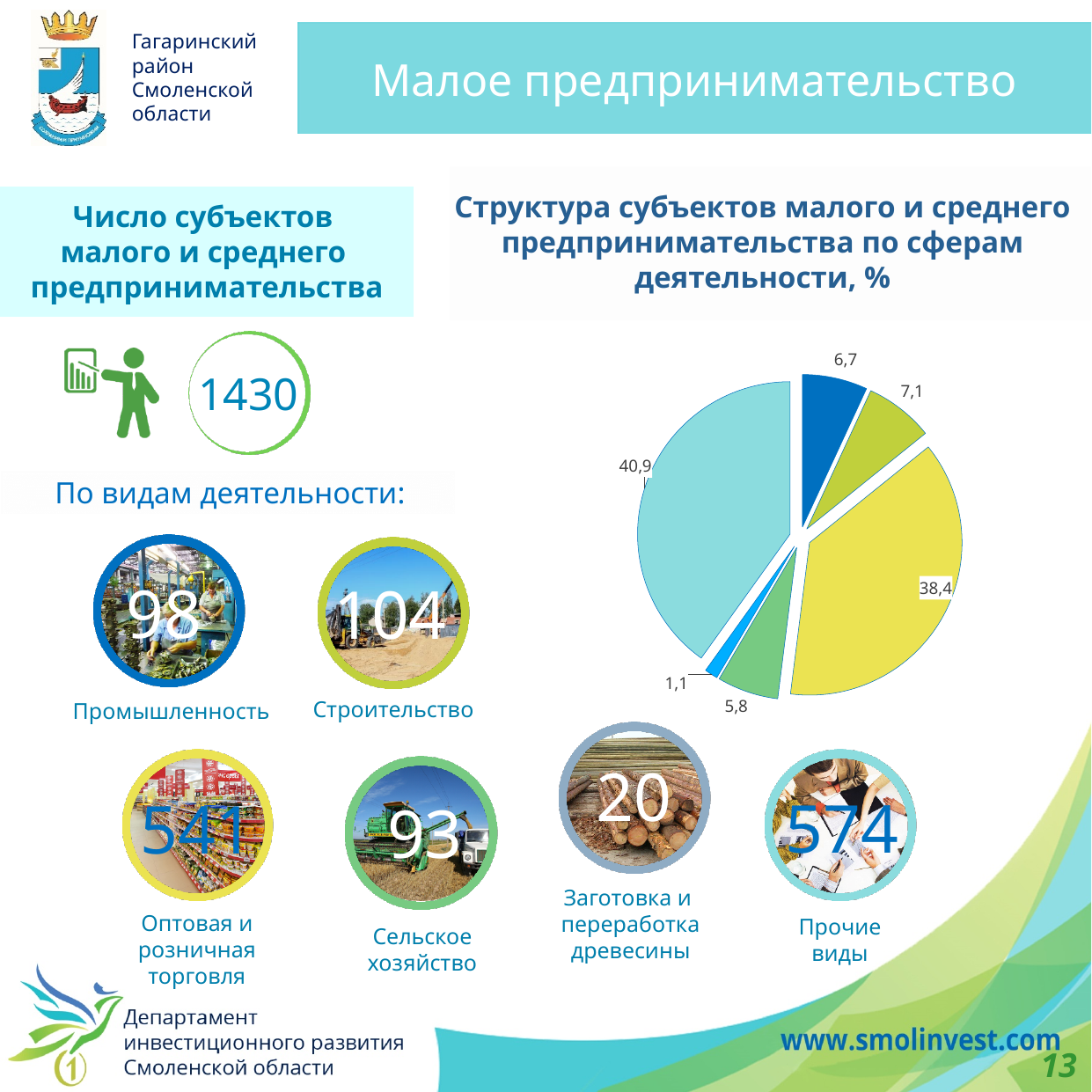
How many slices in the pie chart have a value below 10? 4 What is the value of the largest slice in the pie chart? 40,9 What is the combined value of the two largest slices in the pie chart? 79,3 How many slices does the pie chart have? 6 What is the value of the second-largest slice in the pie chart? 38,4 What is the difference between the two largest slices in the pie chart (40,9 and 38,4)? 2,5 In the pie chart, which is larger: the slice labelled 6,7 or the slice labelled 7,1? 7,1 What is the sum of all the slice labels in the pie chart? 100 What is the title of the pie chart on the slide? Структура субъектов малого и среднего предпринимательства по сферам деятельности, % What kind of chart is shown under the title 'Структура субъектов малого и среднего предпринимательства по сферам деятельности, %'? pie chart What is the value of the smallest slice in the pie chart? 1,1 What is the difference between the slices labelled 7,1 and 6,7 in the pie chart? 0,4